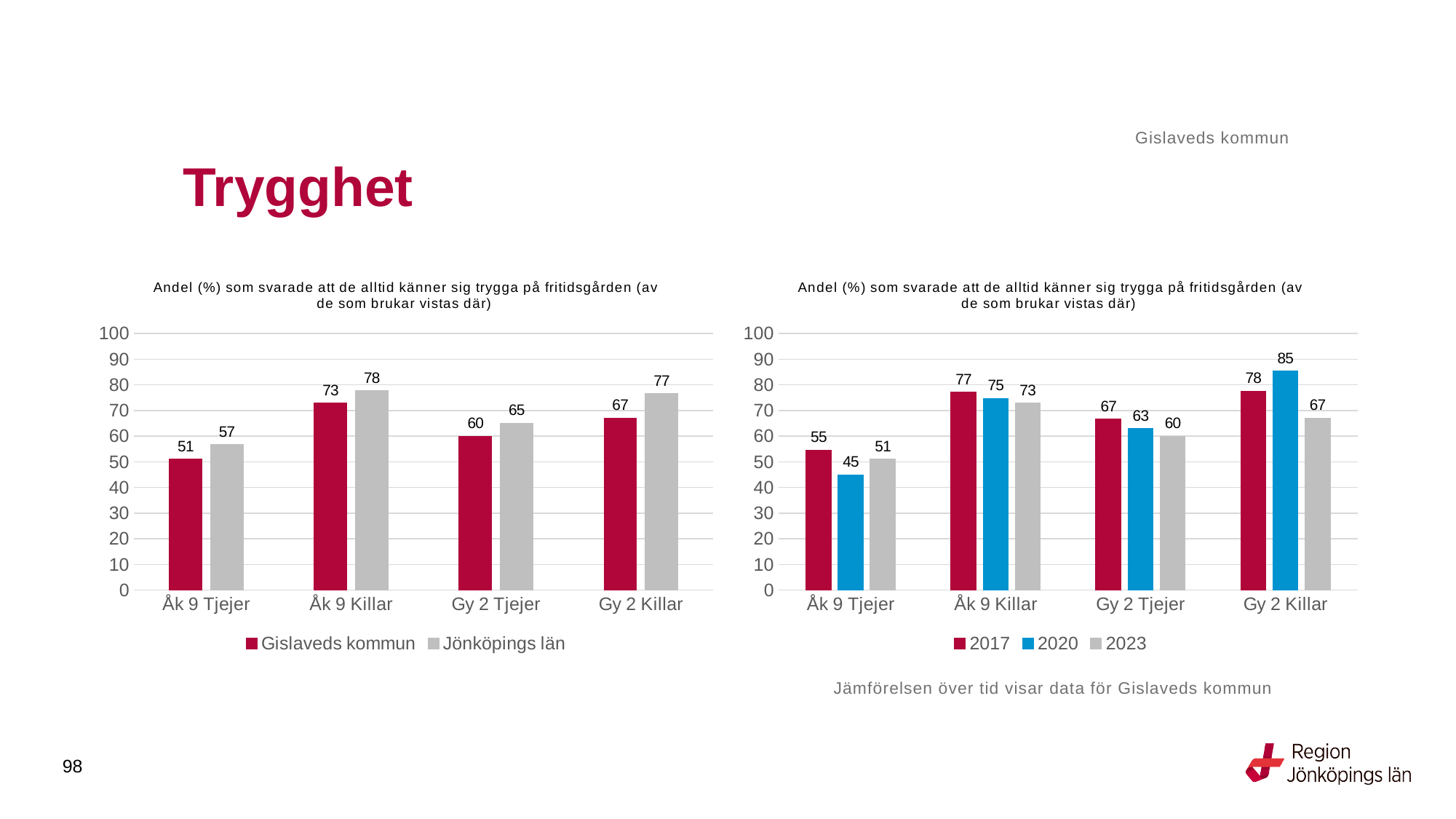
What kind of chart is the left chart? Bar chart In the right chart, what is the difference between the 2017 and 2023 values for Åk 9 Tjejer? 4 In the left chart, what is the value for Gislaveds kommun for Åk 9 Tjejer? 51 In the left chart, what is the difference between Jönköpings län and Gislaveds kommun for Gy 2 Killar? 10 In the right chart, which category has the lowest value for 2017? Åk 9 Tjejer In the left chart, what is the value for Jönköpings län for Gy 2 Killar? 77 In the left chart, which category has the highest value for Jönköpings län? Åk 9 Killar In the right chart, which is larger for Gy 2 Killar: the 2020 value or the 2023 value? 2020 In the left chart, how many series does the legend list? 2 In the right chart, how many series does the legend list? 3 In the right chart, what is the value for 2020 for Åk 9 Tjejer? 45 In the right chart, what is the value for 2023 for Gy 2 Killar? 67